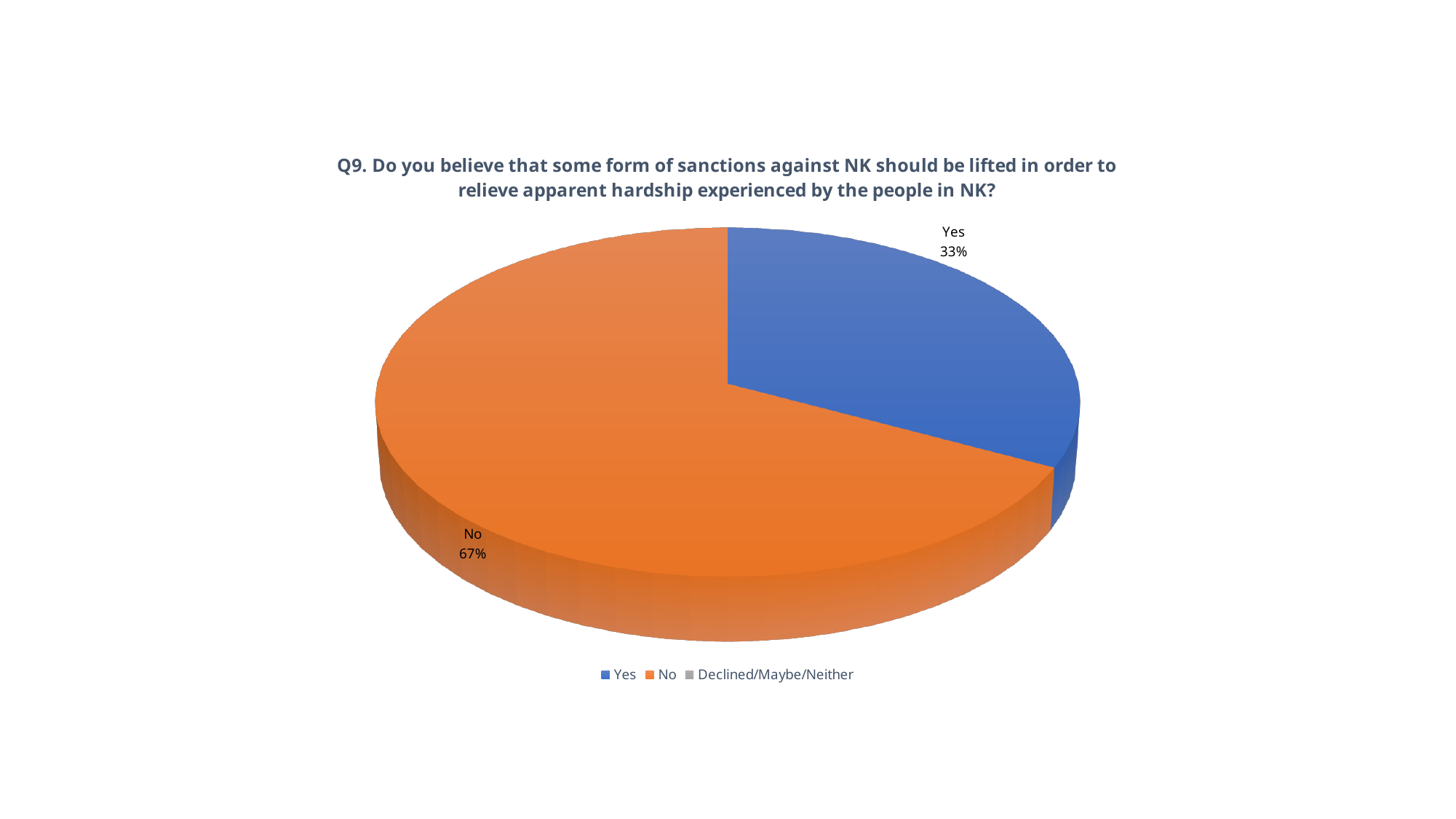
What percentage of respondents answered "No"? 67% What colour is the "No" slice? Orange What is the third legend entry after "Yes" and "No"? Declined/Maybe/Neither Is the share for "No" larger than the share for "Yes"? Yes How many slices have a visible data label on the pie? 2 What is the difference in percentage points between the "No" and "Yes" shares? 34 How many entries does the legend list? 3 Which response has the largest share of the pie? No Which of the two labelled slices, Yes or No, is smaller? Yes What kind of chart is shown on the slide? Pie chart What percentage of respondents answered "Yes"? 33%